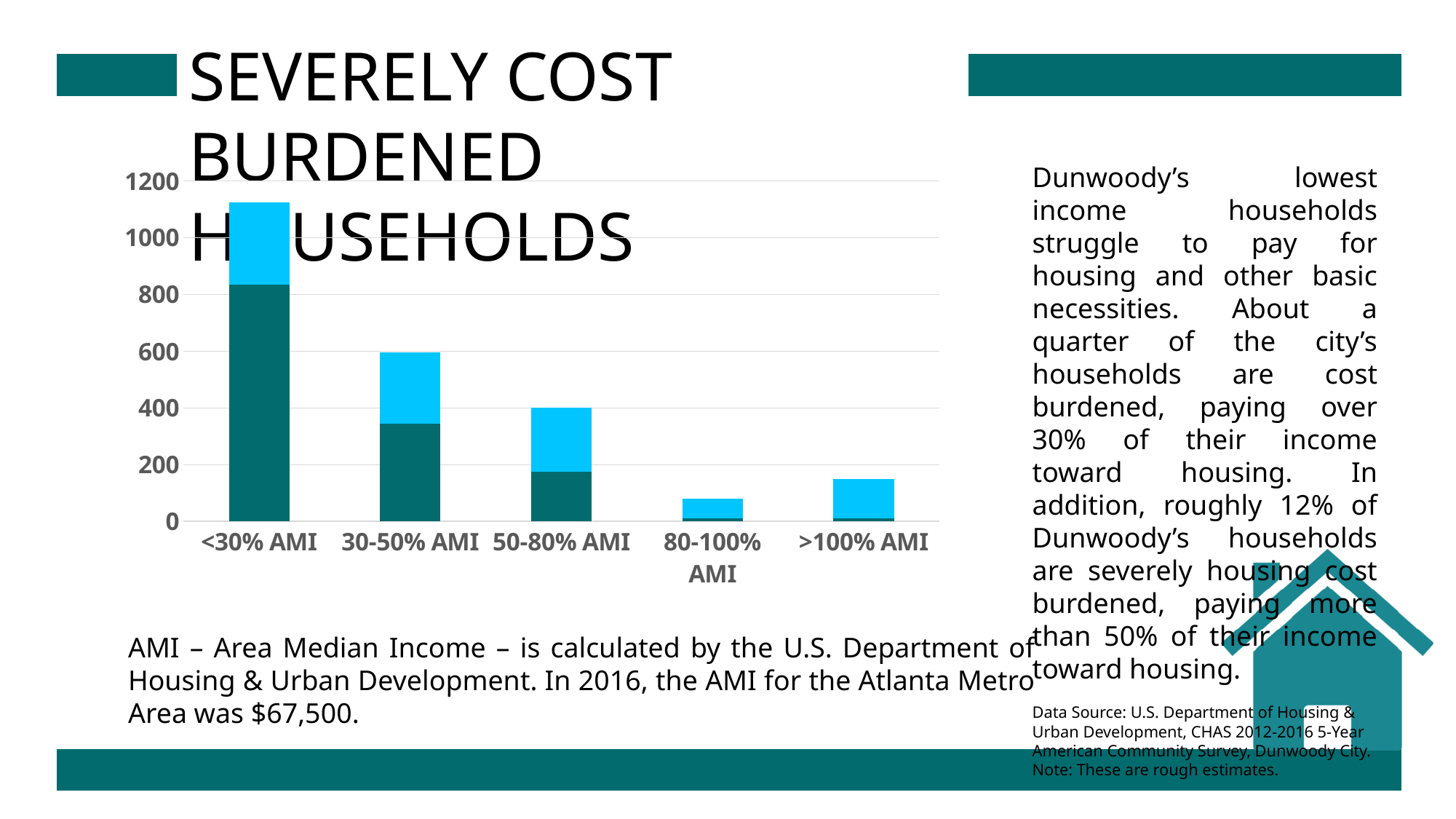
Is the total bar height for >100% AMI greater or less than 200? less Is the total bar height for <30% AMI greater or less than 1000? greater What kind of chart is shown on the slide? bar chart How many income categories are shown on the x axis of the chart? 5 Which income category has the shortest bar in the chart? 80-100% AMI Is the total bar height for 50-80% AMI greater or less than 600? less Do the bar heights rise or fall moving from <30% AMI to 80-100% AMI? fall Which bar is taller, 30-50% AMI or 50-80% AMI? 30-50% AMI Which income category has the tallest bar in the chart? <30% AMI Which bar is taller, 80-100% AMI or >100% AMI? >100% AMI